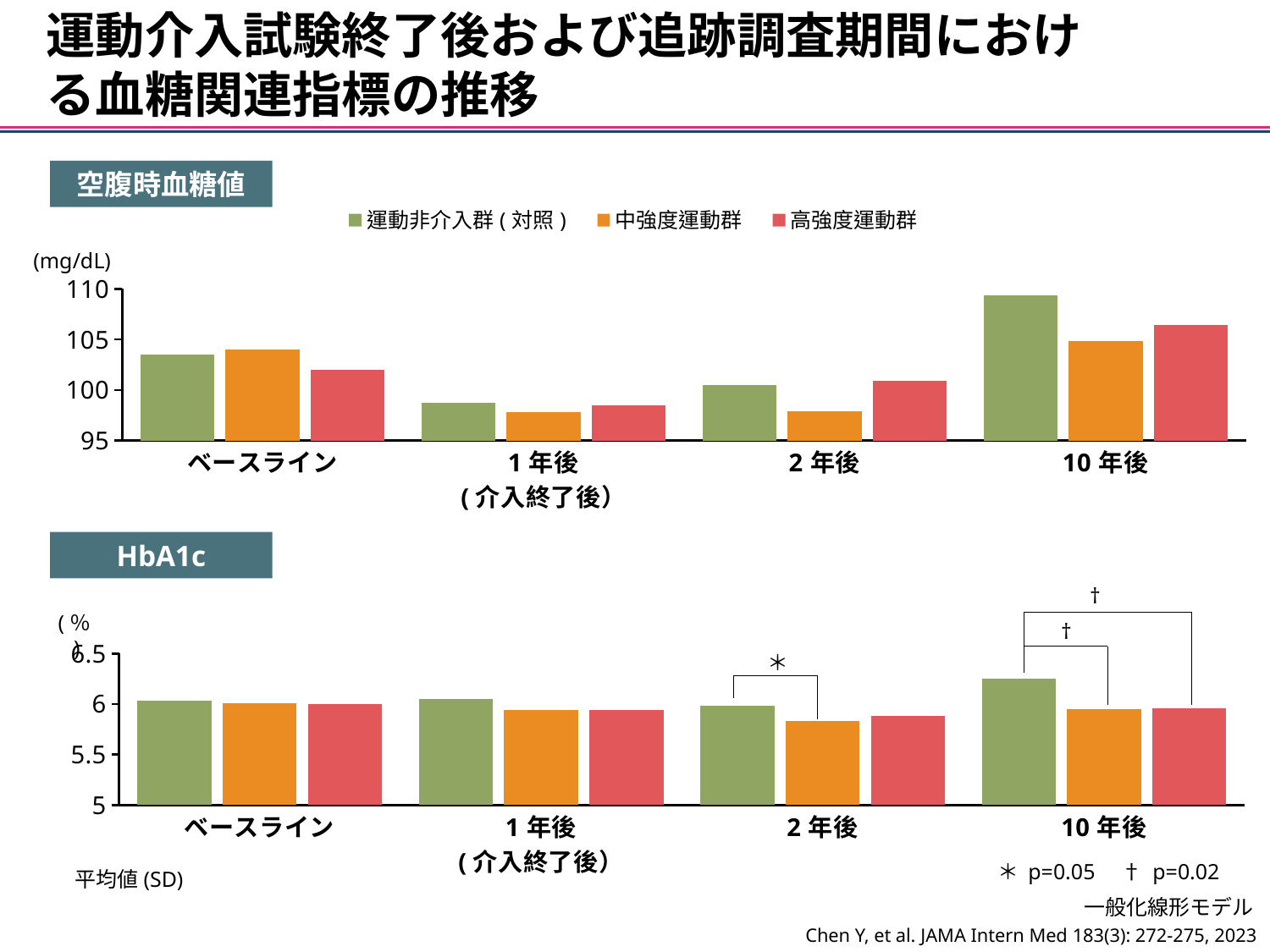
In the 空腹時血糖値 chart, is the value for 中強度運動群 at 1年後 greater or less than 100? less What kind of chart is the 空腹時血糖値 chart? bar chart In the HbA1c chart, is the value for 運動非介入群(対照) at 10年後 greater or less than 6? greater In the 空腹時血糖値 chart, at ベースライン, which is larger: 中強度運動群 or 高強度運動群? 中強度運動群 In the HbA1c chart, is the value for 中強度運動群 at 2年後 greater or less than 6? less In the 空腹時血糖値 chart, which group has the highest bar at 10年後? 運動非介入群(対照) How many series does the legend list for the 空腹時血糖値 chart? 3 What unit is shown on the y axis of the 空腹時血糖値 chart? mg/dL In the 空腹時血糖値 chart, do the values for 運動非介入群(対照) rise or fall from 1年後 to 10年後? rise How many time-point categories are shown on the x axis of the HbA1c chart? 4